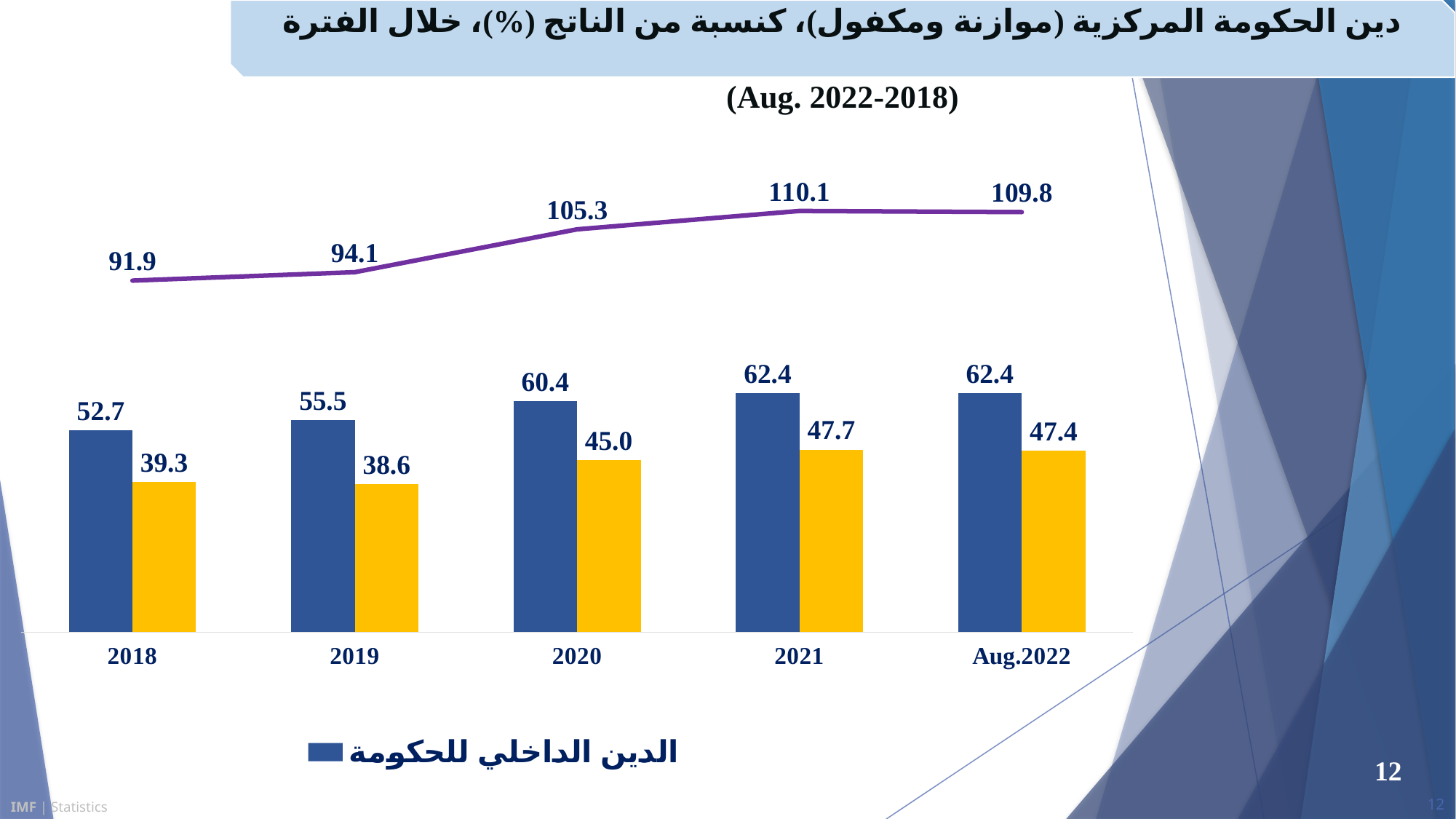
Which year has the lowest value for the yellow bars? 2019 How many time periods are shown on the x axis? 5 What is the value of the blue bar (الدين الداخلي للحكومة) for Aug.2022? 62.4 What series name is shown in the legend next to the blue marker? الدين الداخلي للحكومة What is the value of the blue bar (الدين الداخلي للحكومة) for 2020? 60.4 By how much did the purple line value change from 2019 to 2020? 11.2 Which is larger: the yellow bar for 2021 or the yellow bar for Aug.2022? 2021 What is the difference between the blue bar and the yellow bar in 2018? 13.4 What value does the purple line show for 2021? 110.1 What is the value of the yellow bar for 2019? 38.6 Does the purple line generally rise or fall from 2018 to 2021? rise In which year does the purple line reach its highest value? 2021